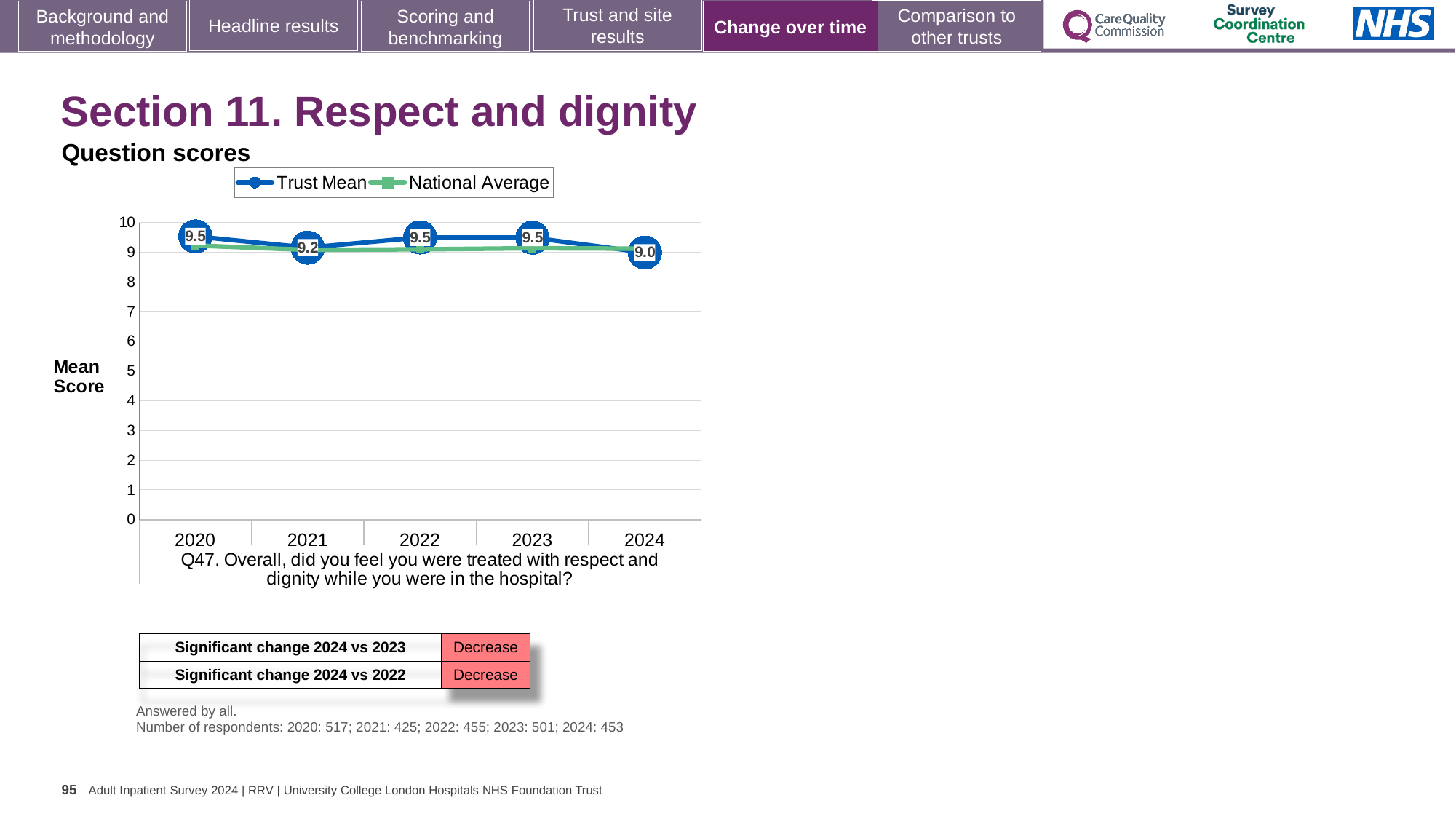
What are the two series named in the chart legend? Trust Mean and National Average Which year has the larger Trust Mean score, 2021 or 2024? 2021 What is the Trust Mean score for 2020? 9.5 What is the Trust Mean score for 2024? 9.0 How many years are shown on the x axis of the chart? 5 What kind of chart is shown on the slide? Line chart Is the National Average value for 2024 greater or less than 8? greater Does the Trust Mean score rise or fall from 2023 to 2024? Fall What is the Trust Mean score for 2021? 9.2 How many series does the chart legend list? 2 What is the difference between the Trust Mean score in 2020 and in 2024? 0.5 In which year is the Trust Mean score lowest? 2024